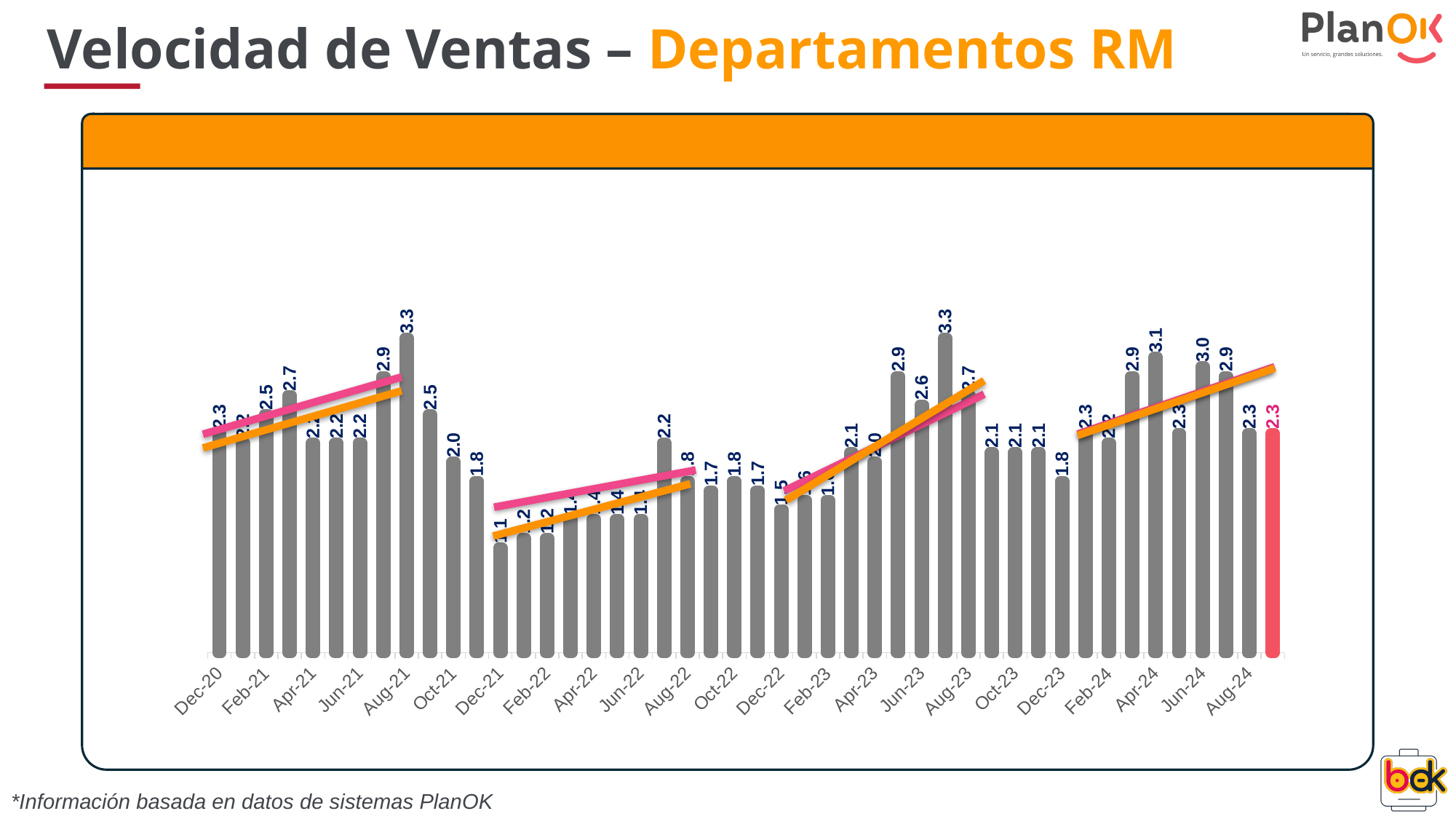
What is the value for Aug-21? 3.3 What is the difference between the values for Aug-21 and Dec-21? 2.2 What kind of chart is shown on the slide? bar chart What is the value for Dec-21? 1.1 What is the value for Aug-24? 2.3 What is the highest value shown on the chart? 3.3 What is the value for Dec-22? 1.5 Which is larger, the value for Aug-21 or the value for Aug-24? Aug-21 What is the value of the red bar at the right end of the chart? 2.3 What is the difference between the values for Apr-24 and Dec-23? 1.3 What is the lowest value shown on the chart? 1.1 What is the value for Apr-24? 3.1